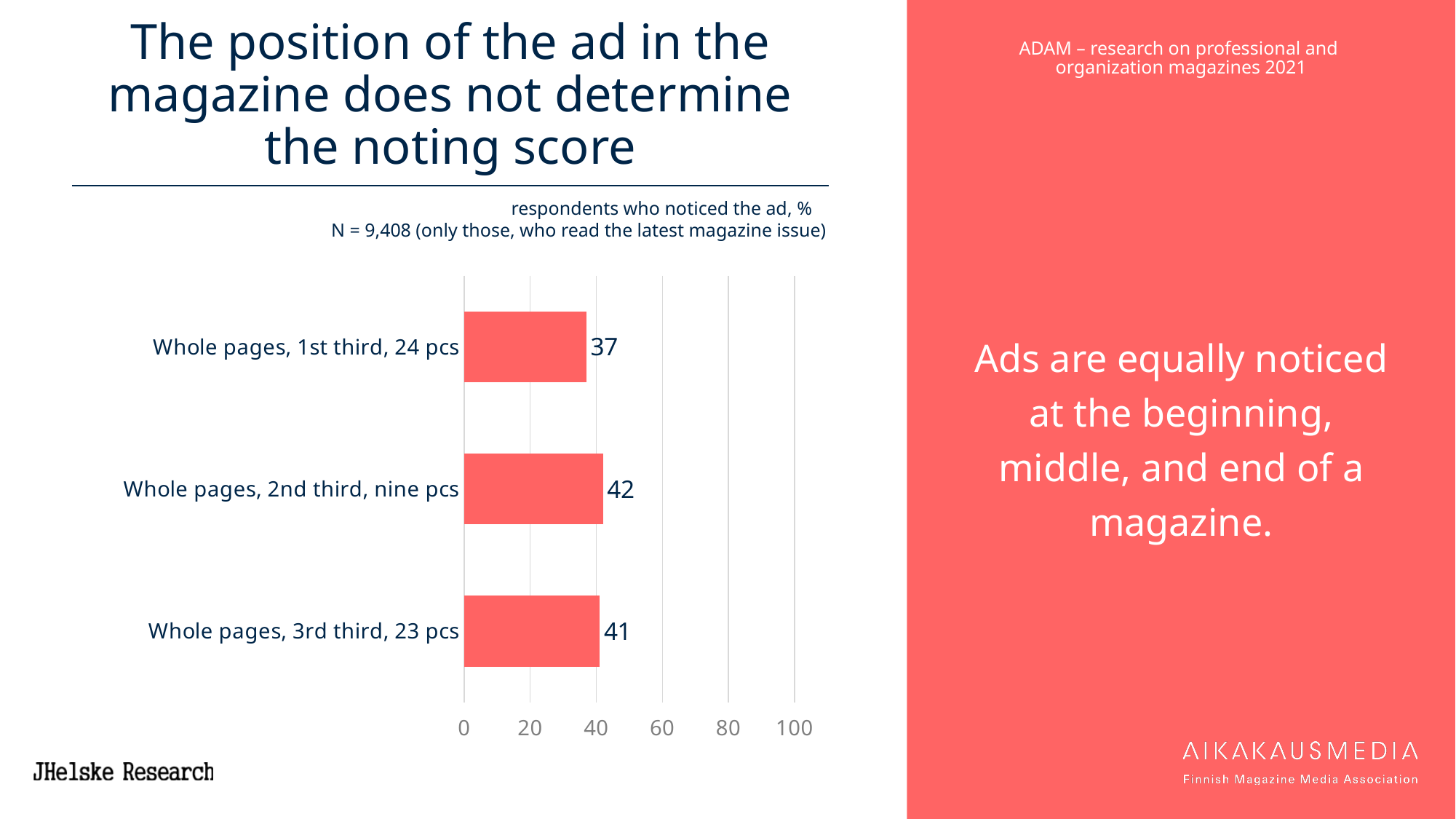
What is the difference between the values for "Whole pages, 2nd third, nine pcs" and "Whole pages, 1st third, 24 pcs"? 5 Which category has the highest value? Whole pages, 2nd third, nine pcs What is the value for "Whole pages, 2nd third, nine pcs"? 42 What is the value for "Whole pages, 3rd third, 23 pcs"? 41 Which is larger, the value for "Whole pages, 1st third, 24 pcs" or "Whole pages, 3rd third, 23 pcs"? Whole pages, 3rd third, 23 pcs Which category has the lowest value? Whole pages, 1st third, 24 pcs What is the difference between the values for "Whole pages, 3rd third, 23 pcs" and "Whole pages, 1st third, 24 pcs"? 4 What is the value for "Whole pages, 1st third, 24 pcs"? 37 How many categories are shown in the chart? 3 What kind of chart is shown on the slide? bar chart Is the value for "Whole pages, 1st third, 24 pcs" greater or less than 40? less What is the highest value shown on the x axis? 100